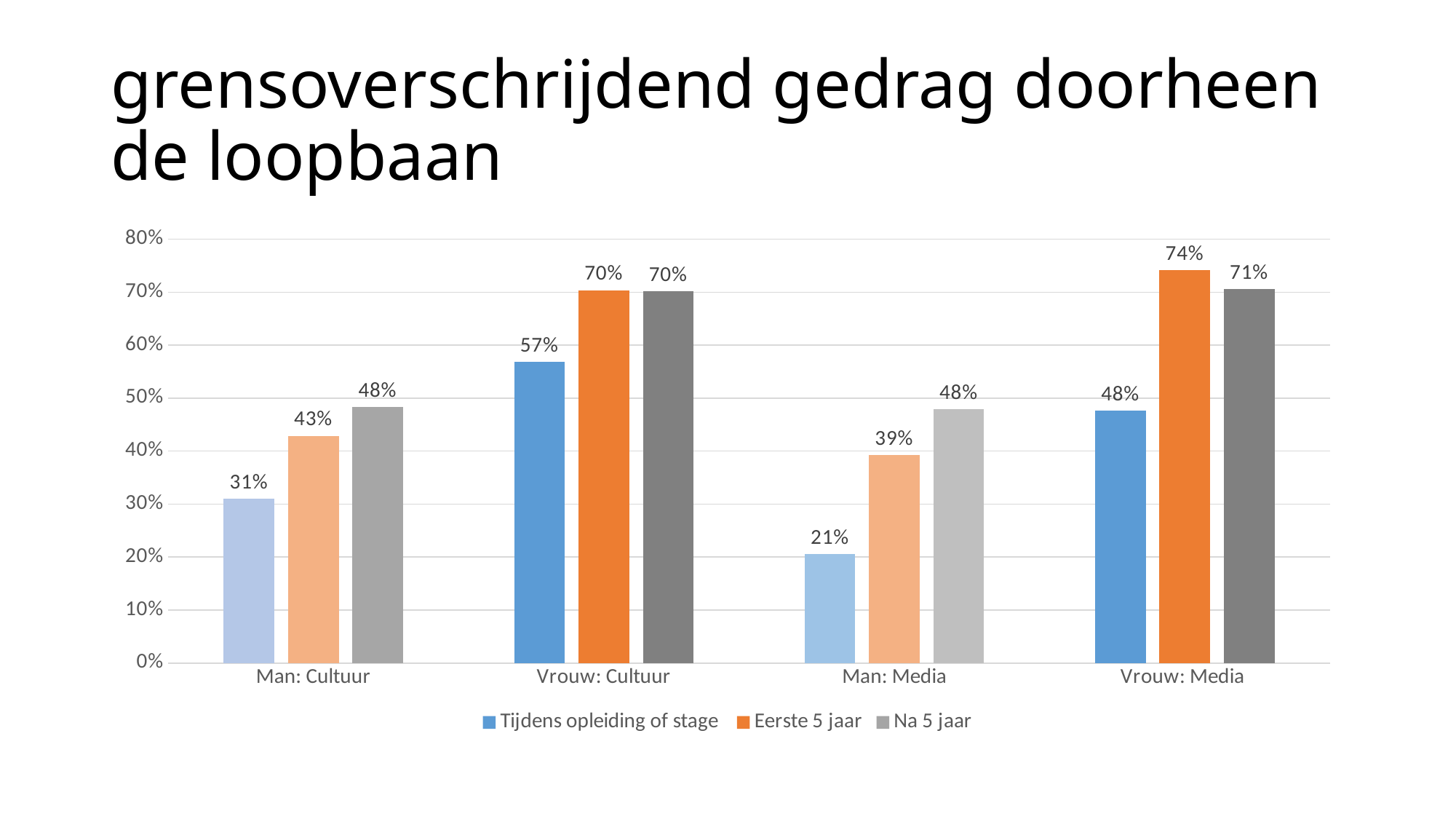
Which is larger: the "Na 5 jaar" value for Man: Cultuur or the "Tijdens opleiding of stage" value for Vrouw: Cultuur? Tijdens opleiding of stage for Vrouw: Cultuur How many series does the legend list? 3 What is the value for "Tijdens opleiding of stage" in the Man: Cultuur category? 31% Which category has the lowest value for "Tijdens opleiding of stage"? Man: Media What is the value for "Na 5 jaar" in the Man: Media category? 48% What kind of chart is shown on the slide? bar chart What is the value for "Eerste 5 jaar" in the Vrouw: Media category? 74% What is the difference between the "Eerste 5 jaar" value and the "Tijdens opleiding of stage" value for Man: Media? 18% Which category has the highest value for "Eerste 5 jaar"? Vrouw: Media Which series is shown in orange in the legend? Eerste 5 jaar How many categories are shown on the x axis? 4 Is the "Eerste 5 jaar" value for Man: Cultuur greater or less than 50%? less